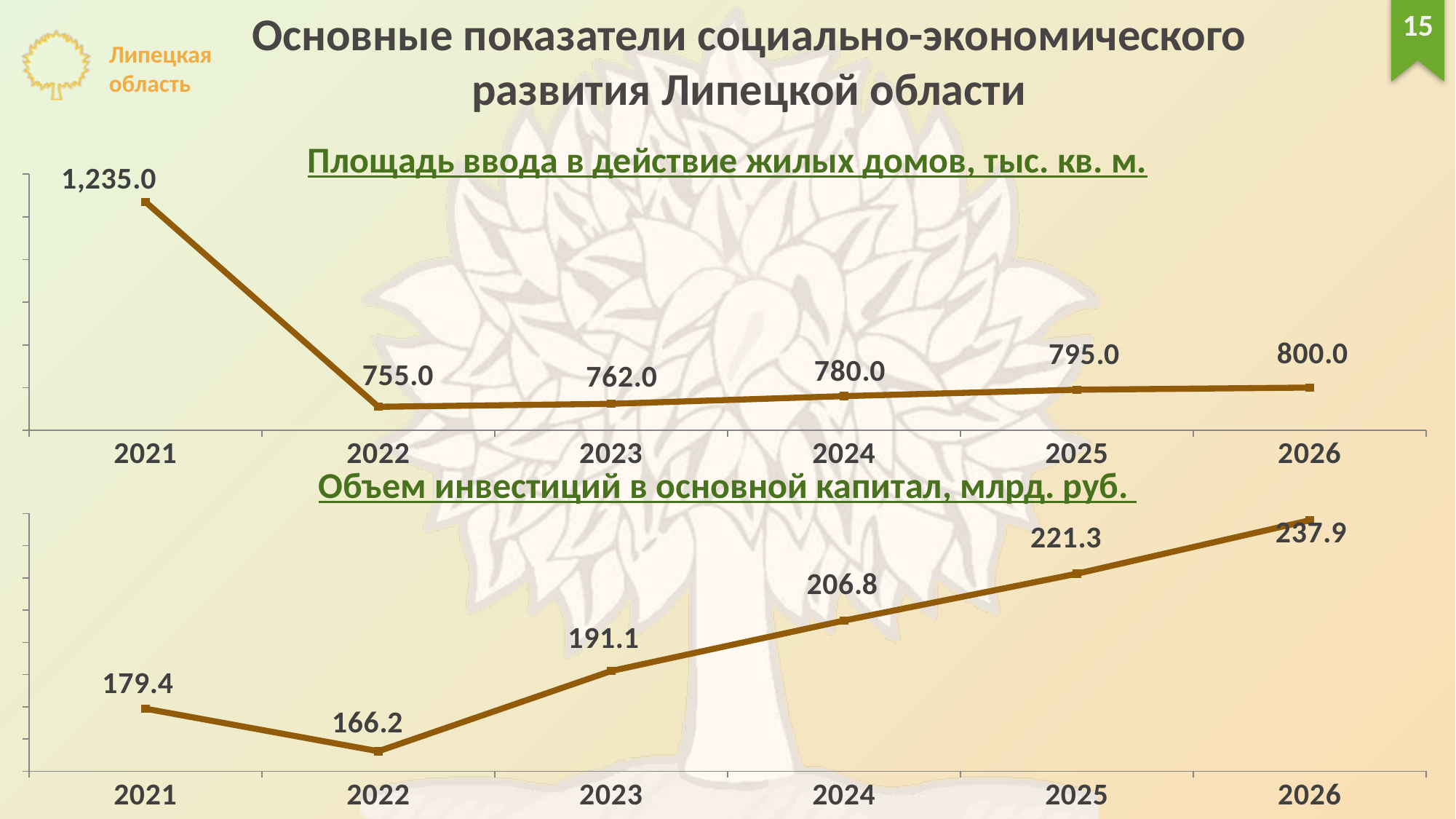
In the chart 'Объем инвестиций в основной капитал, млрд. руб.', which year has the lowest value? 2022 In the chart 'Площадь ввода в действие жилых домов, тыс. кв. м.', what is the value for 2021? 1,235.0 In the chart 'Объем инвестиций в основной капитал, млрд. руб.', what is the difference between the values for 2026 and 2025? 16.6 In the chart 'Объем инвестиций в основной капитал, млрд. руб.', which year has the highest value? 2026 In the chart 'Площадь ввода в действие жилых домов, тыс. кв. м.', how many years are plotted? 6 In the chart 'Площадь ввода в действие жилых домов, тыс. кв. м.', which year has the lowest value? 2022 In the chart 'Объем инвестиций в основной капитал, млрд. руб.', do the values rise or fall from 2022 to 2026? rise In the chart 'Площадь ввода в действие жилых домов, тыс. кв. м.', what is the difference between the values for 2021 and 2022? 480.0 In the chart 'Объем инвестиций в основной капитал, млрд. руб.', what is the value for 2023? 191.1 What type of chart is the bottom chart on the slide? line chart In the chart 'Площадь ввода в действие жилых домов, тыс. кв. м.', what is the value for 2024? 780.0 In the chart 'Объем инвестиций в основной капитал, млрд. руб.', which is larger: the value for 2021 or the value for 2022? 2021